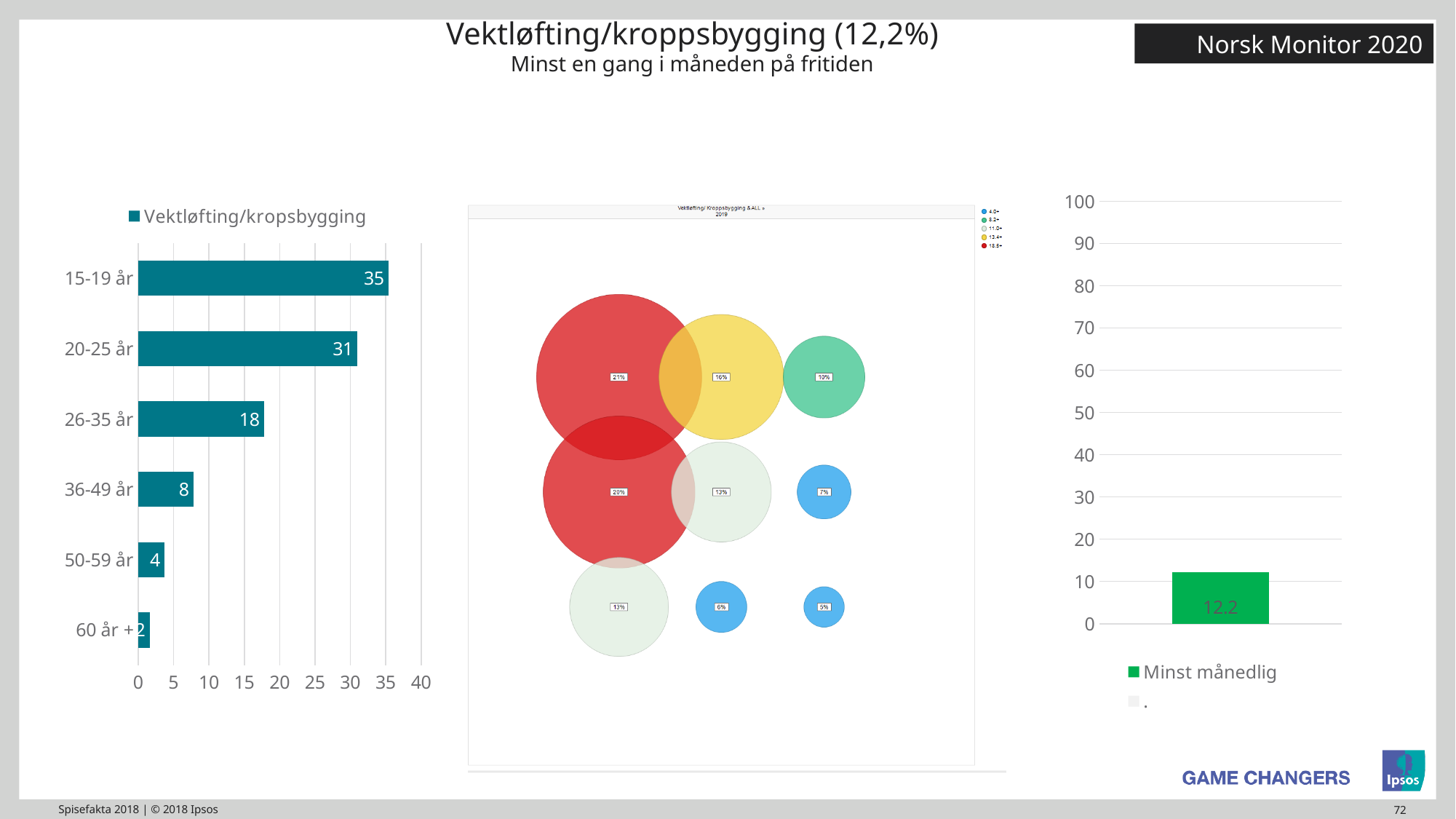
In the left bar chart, what is the value for 50-59 år? 4 Do the values in the left bar chart rise or fall as the age groups get older? fall What kind of chart is the chart on the left of the slide? bar chart In the left bar chart, which is larger, the value for 36-49 år or the value for 50-59 år? 36-49 år In the left bar chart, what is the difference between the values for 15-19 år and 20-25 år? 4 In the left bar chart, what is the value for 26-35 år? 18 How many age groups are shown in the left bar chart? 6 In the left bar chart, which age group has the lowest value? 60 år + In the right bar chart, what is the value of the Minst månedlig bar? 12.2 In the right bar chart, is the value for Minst månedlig greater or less than 20? less In the left bar chart, which age group has the highest value? 15-19 år In the left bar chart, what is the value for 15-19 år? 35